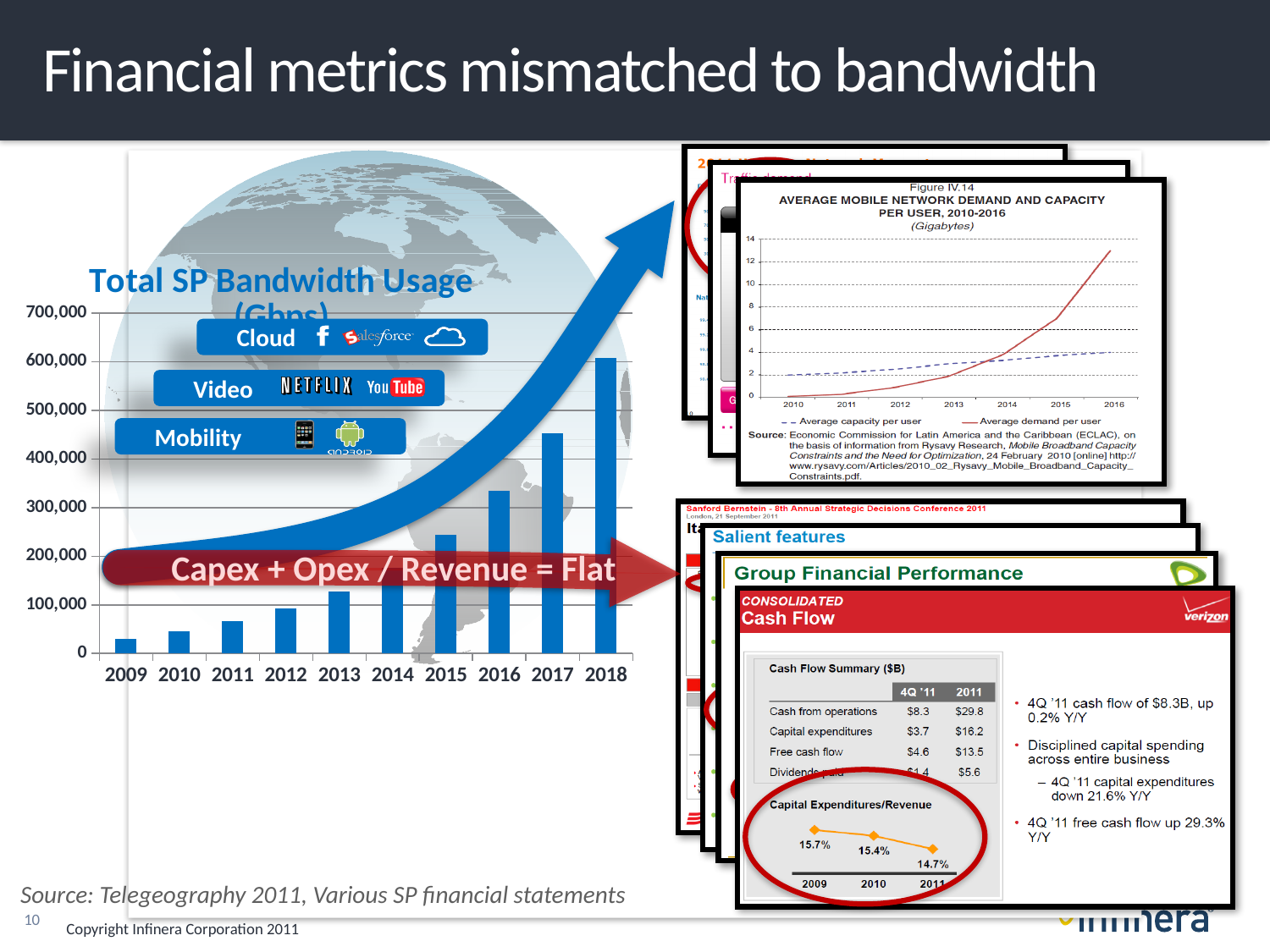
In the Total SP Bandwidth Usage chart, do the values rise or fall from 2009 to 2018? rise In the Total SP Bandwidth Usage chart, is the value for 2009 greater or less than 100,000? less How many series does the legend list in the Average Mobile Network Demand and Capacity per User chart? 2 In the Total SP Bandwidth Usage chart, which year has the highest bandwidth usage? 2018 In the Total SP Bandwidth Usage chart, is the value for 2017 greater or less than 500,000? less What kind of chart is the Total SP Bandwidth Usage chart? bar chart In the Capital Expenditures/Revenue chart on the Verizon cash flow slide, what is the value for 2009? 15.7% In the Capital Expenditures/Revenue chart on the Verizon cash flow slide, what is the difference between the 2009 and 2011 values? 1.0% In the Total SP Bandwidth Usage chart, is the value for 2018 greater or less than 500,000? greater In the Total SP Bandwidth Usage chart, which year has the lowest bandwidth usage? 2009 In the Total SP Bandwidth Usage chart, how many years are shown on the x axis? 10